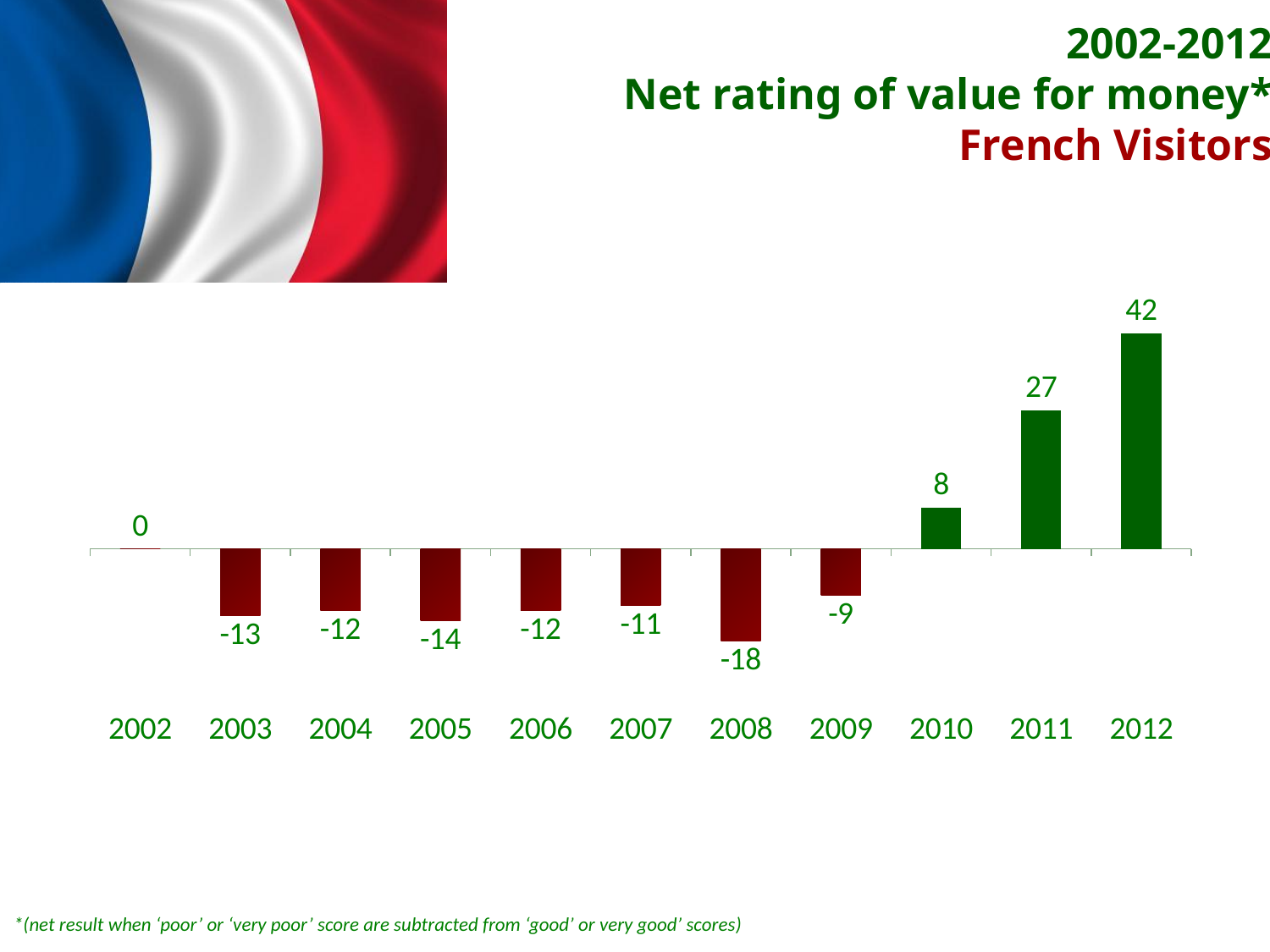
Which year has the lowest net rating of value for money? 2008 What is the net rating of value for money for French visitors in 2008? -18 What is the net rating of value for money for French visitors in 2002? 0 How many years are shown on the x axis of the chart? 11 Which year has a higher net rating, 2010 or 2011? 2011 Which year has the highest net rating of value for money? 2012 Do the net ratings generally rise or fall from 2008 to 2012? Rise What is the net rating of value for money for French visitors in 2012? 42 What colour are the bars for years with a negative net rating? Dark red What is the difference between the net rating in 2012 and the net rating in 2011? 15 What kind of chart is used to show the net rating of value for money? Bar chart Which year has a lower net rating, 2005 or 2009? 2005